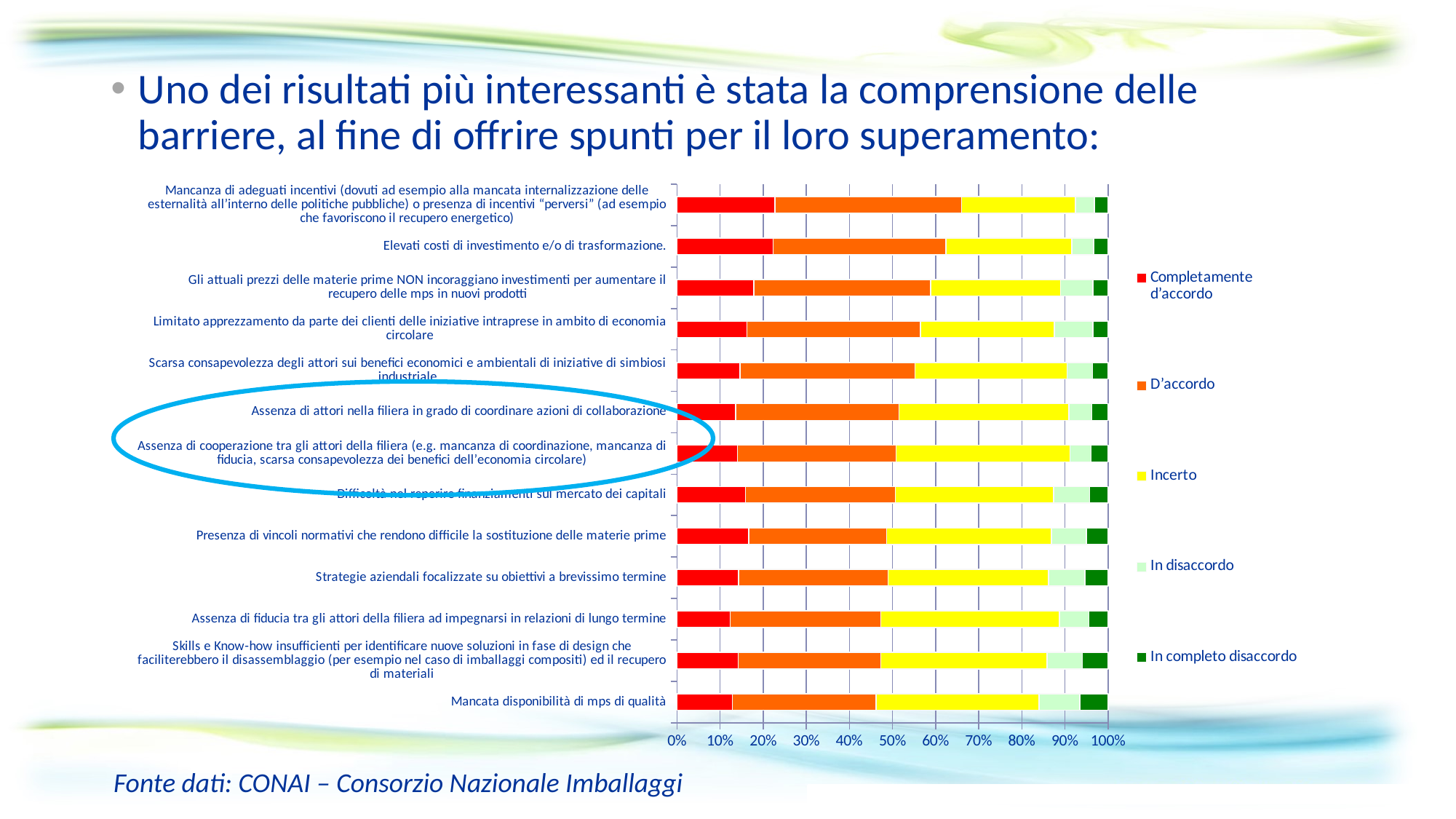
What is the highest value shown on the horizontal axis? 100% Is the 'Completamente d'accordo' share for 'Assenza di fiducia tra gli attori della filiera ad impegnarsi in relazioni di lungo termine' greater or less than 20%? less Which has the larger 'Completamente d'accordo' share: 'Mancanza di adeguati incentivi' or 'Mancata disponibilità di mps di qualità'? Mancanza di adeguati incentivi What kind of chart is shown on the slide? Stacked bar chart Which legend entry is shown in yellow? Incerto Going from the top bar to the bottom bar, does the combined 'Completamente d'accordo' plus 'D'accordo' portion get longer or shorter? shorter Is the 'Completamente d'accordo' share for 'Elevati costi di investimento e/o di trasformazione' greater or less than 10%? greater How many series does the chart legend list? 5 Which category is listed at the bottom of the chart? Mancata disponibilità di mps di qualità Is the 'Completamente d'accordo' share for 'Mancanza di adeguati incentivi' greater or less than 20%? greater How many barrier categories are plotted in the chart? 13